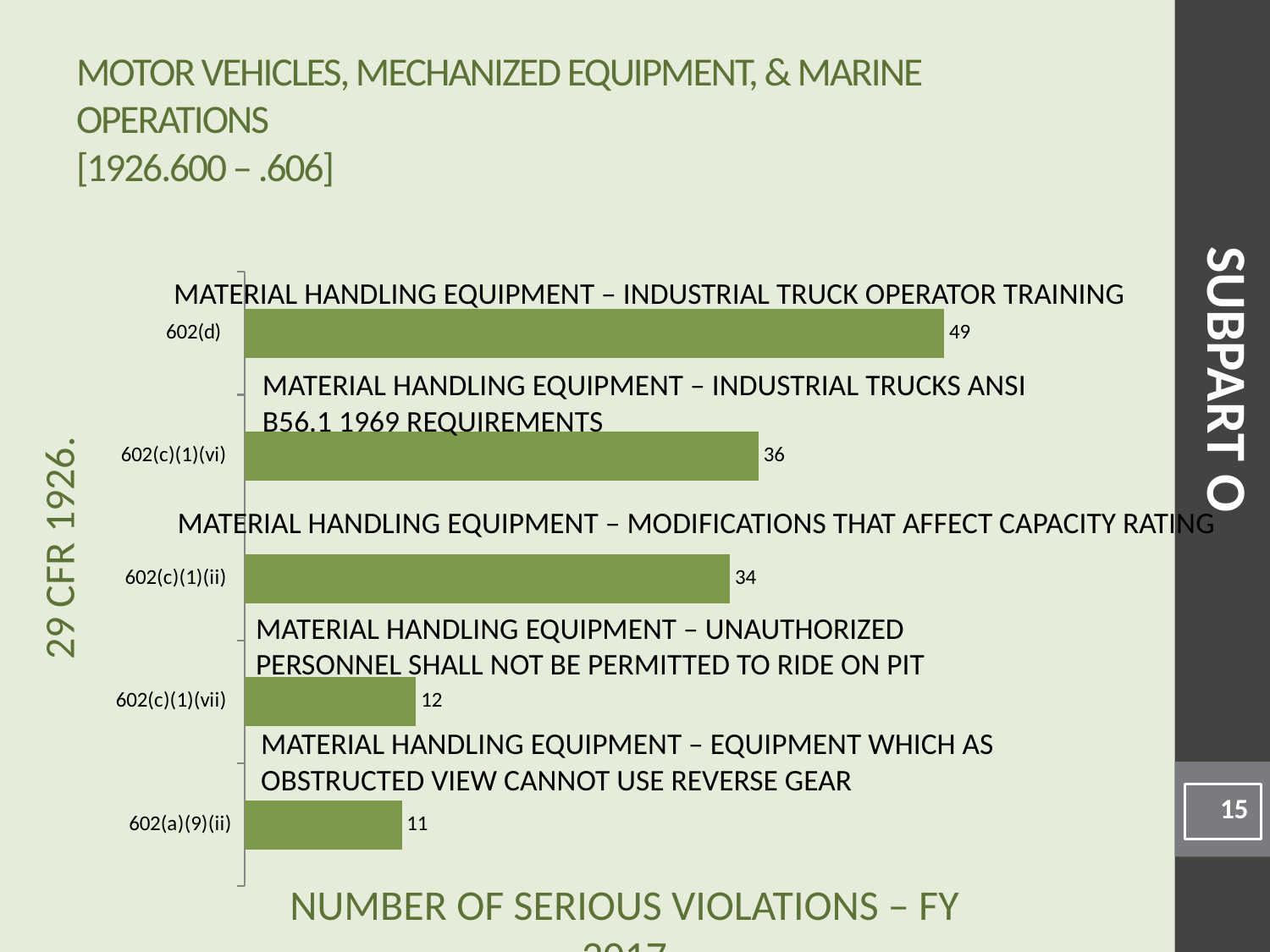
What kind of chart is shown on the slide? bar chart What is the number of serious violations for 602(d)? 49 How many standards are shown in the chart? 5 What is the number of serious violations for 602(a)(9)(ii)? 11 Which standard has the lowest number of serious violations? 602(a)(9)(ii) What is the number of serious violations for 602(c)(1)(ii)? 34 Which has more serious violations, 602(c)(1)(vi) or 602(c)(1)(ii)? 602(c)(1)(vi) What is the difference between the number of serious violations for 602(d) and 602(c)(1)(vi)? 13 What is the number of serious violations for 602(c)(1)(vi)? 36 What is the difference between the number of serious violations for 602(c)(1)(vii) and 602(a)(9)(ii)? 1 Which standard has the highest number of serious violations? 602(d)